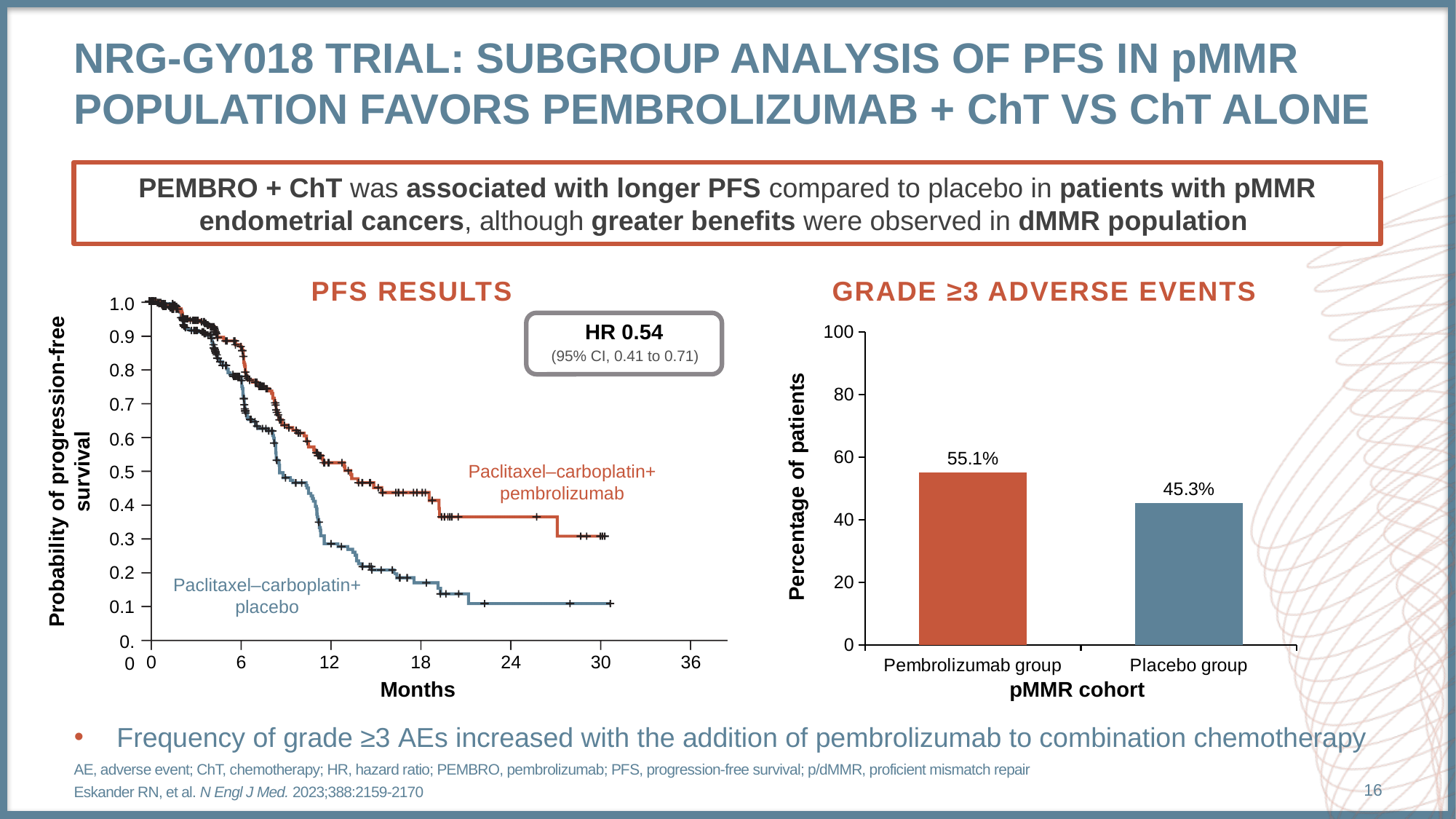
In the Grade ≥3 Adverse Events chart, which group has the higher percentage of patients? Pembrolizumab group In the Grade ≥3 Adverse Events chart, what percentage of patients is shown for the Pembrolizumab group? 55.1% What kind of chart is the Grade ≥3 Adverse Events chart? Bar chart In the PFS Results chart, how many treatment curves are plotted? 2 In the PFS Results chart, is the probability of progression-free survival for the Paclitaxel–carboplatin+placebo curve at 12 months greater or less than 0.4? less In the Grade ≥3 Adverse Events chart, what percentage of patients is shown for the Placebo group? 45.3% In the PFS Results chart, which curve is higher at 18 months, Paclitaxel–carboplatin+pembrolizumab or Paclitaxel–carboplatin+placebo? Paclitaxel–carboplatin+pembrolizumab In the Grade ≥3 Adverse Events chart, what is the difference in percentage points between the Pembrolizumab group and the Placebo group? 9.8% In the Grade ≥3 Adverse Events chart, how many groups are plotted? 2 In the PFS Results chart, what hazard ratio is shown? HR 0.54 In the PFS Results chart, is the probability of progression-free survival for the Paclitaxel–carboplatin+pembrolizumab curve at 24 months greater or less than 0.3? greater In the Grade ≥3 Adverse Events chart, what is the label on the x axis? pMMR cohort